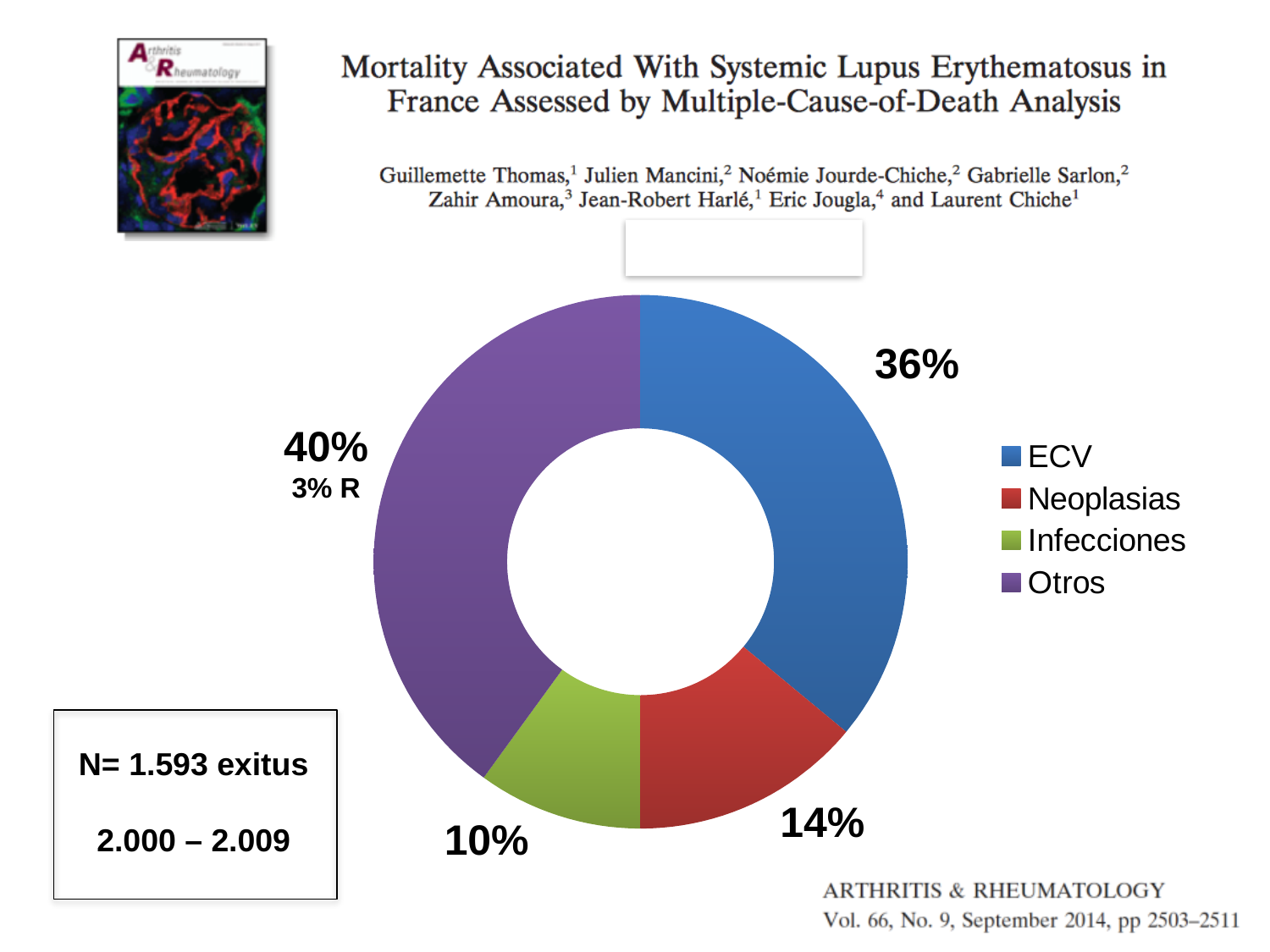
How many categories does the chart show? 4 Which is larger, the share for ECV or the share for Neoplasias? ECV Which category has the largest share in the chart? Otros Which colour represents Infecciones in the chart? Green What is the difference in percentage points between Neoplasias and Infecciones? 4 What percentage is shown for Neoplasias in the chart? 14% What is the difference in percentage points between Otros and ECV? 4 What percentage is shown for Otros in the chart? 40% What kind of chart is shown on the slide? Doughnut chart What percentage is shown for Infecciones in the chart? 10% Which category has the smallest share in the chart? Infecciones What percentage of the doughnut chart is labelled for ECV? 36%